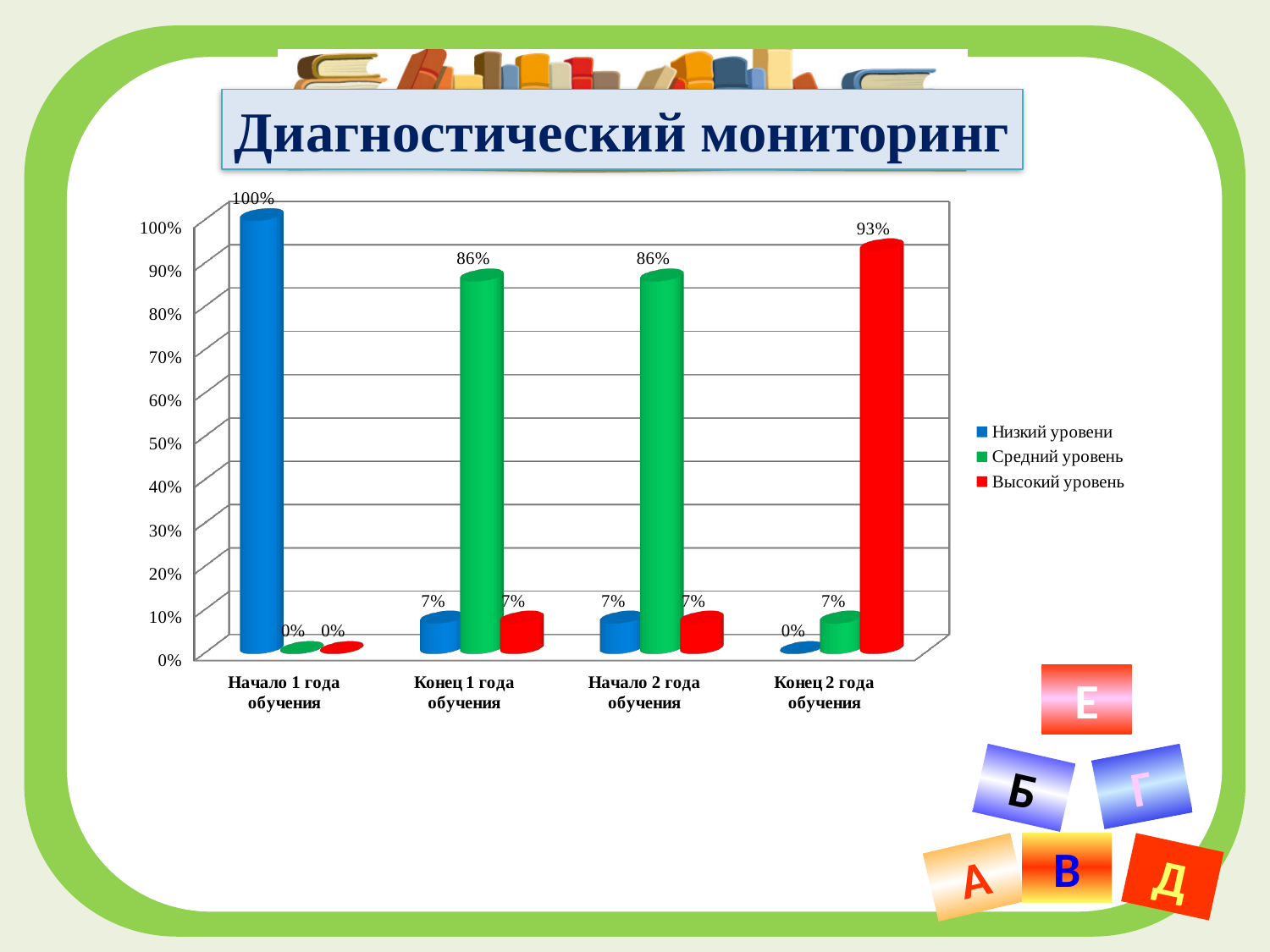
What is the value of Высокий уровень for Конец 2 года обучения? 93% What is the value of Средний уровень for Конец 1 года обучения? 86% What is the difference between Высокий уровень for Конец 2 года обучения and Высокий уровень for Начало 2 года обучения? 86% How many series does the legend list? 3 Which is larger: Низкий уровени for Начало 1 года обучения or Высокий уровень for Конец 2 года обучения? Низкий уровени for Начало 1 года обучения What is the value of Высокий уровень for Начало 1 года обучения? 0% Do the values for Низкий уровени rise or fall from Начало 1 года обучения to Конец 2 года обучения? Fall Which category has the lowest value for Средний уровень? Начало 1 года обучения How many categories are shown on the x axis? 4 What kind of chart is shown on the slide? Bar chart What is the value of Низкий уровени for Начало 1 года обучения? 100% Which category has the highest value for Высокий уровень? Конец 2 года обучения